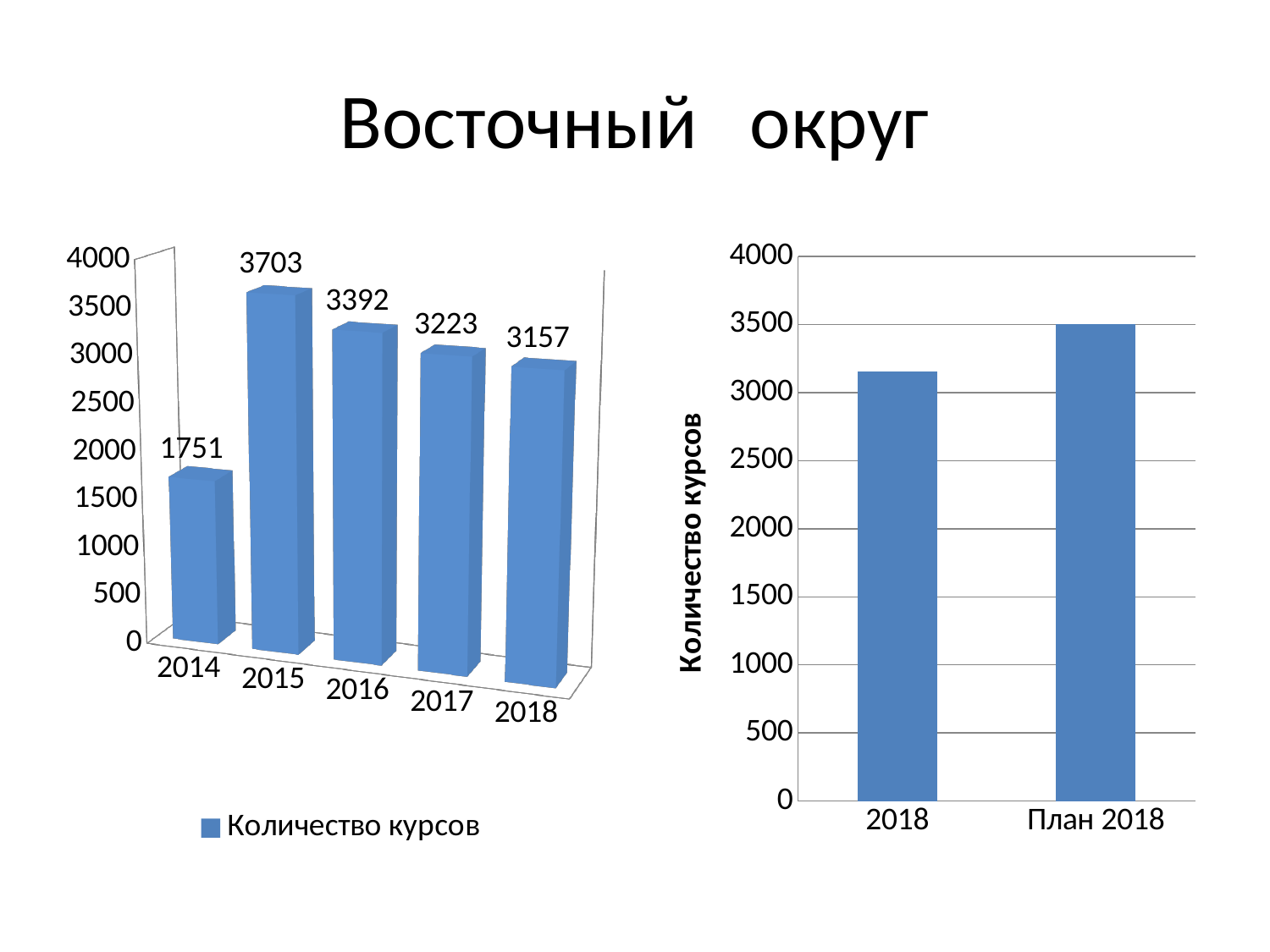
In the left chart, do the values rise or fall from 2015 to 2018? fall In the left chart, which year has the highest value? 2015 In the right chart, is the value for План 2018 greater or less than 3000? greater In the right chart, which is larger, the value for 2018 or the value for План 2018? План 2018 In the left chart, how many years are shown? 5 In the left chart, which year has the lowest value? 2014 In the left chart, what is the value for 2017? 3223 What kind of chart is the right chart? bar chart In the left chart, which is larger, the value for 2016 or the value for 2017? 2016 In the left chart, what is the difference between the values for 2015 and 2018? 546 In the left chart, what series does the legend list? Количество курсов In the left chart, what is the value for 2014? 1751